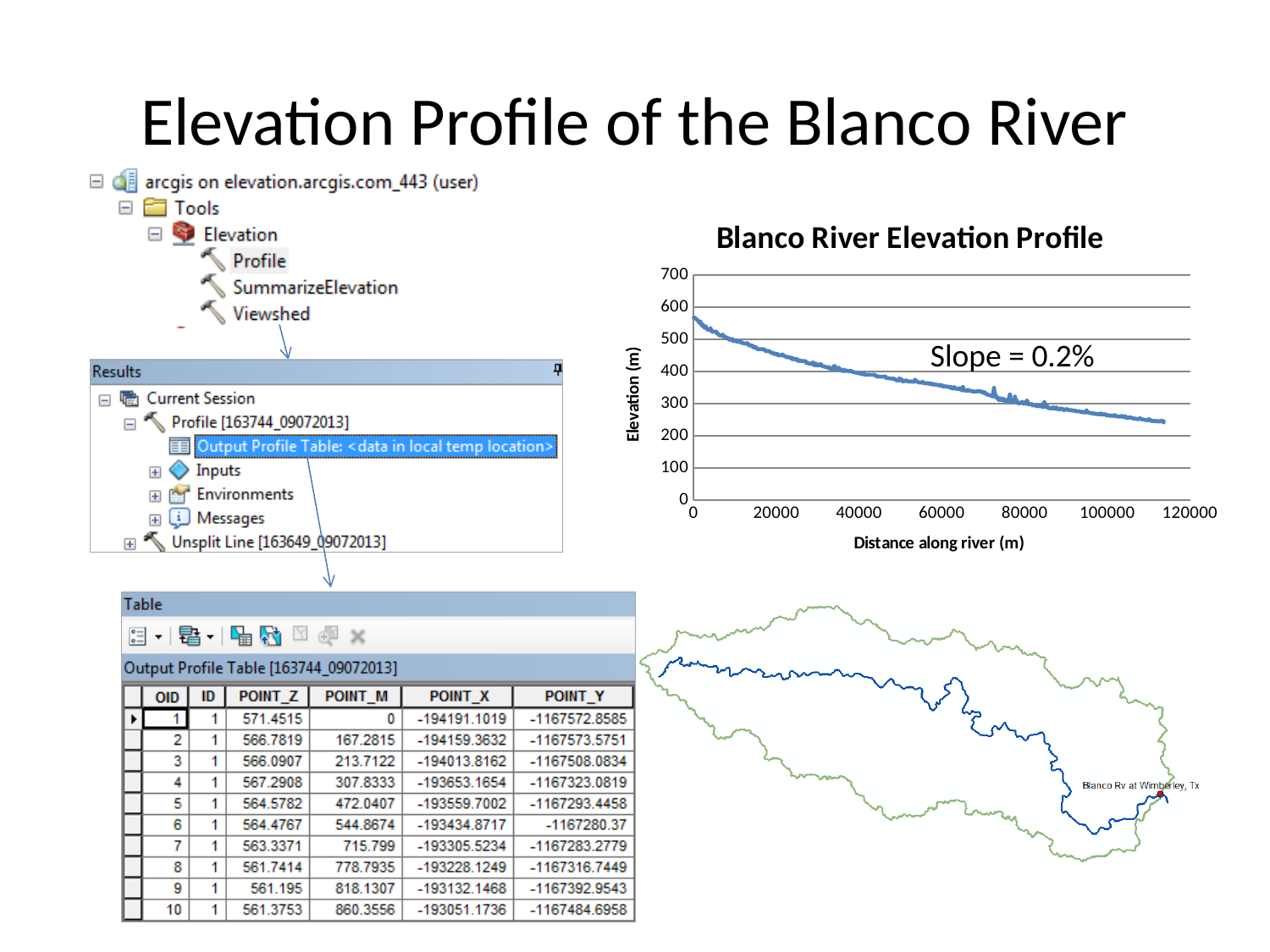
In the Blanco River Elevation Profile chart, is the elevation higher at 20000 m or at 80000 m along the river? 20000 m What slope value is annotated on the Blanco River Elevation Profile chart? Slope = 0.2% In the Blanco River Elevation Profile chart, is the elevation at 60000 m along the river greater or less than 300? greater In the Blanco River Elevation Profile chart, is the elevation at 60000 m along the river greater or less than 400? less What is the maximum value shown on the y axis of the Blanco River Elevation Profile chart? 700 Does elevation rise or fall as distance along the river increases in the Blanco River Elevation Profile chart? fall In the Blanco River Elevation Profile chart, is the elevation at distance 0 m greater or less than 500? greater What is the maximum value shown on the x axis of the Blanco River Elevation Profile chart? 120000 What is the label of the y axis of the Blanco River Elevation Profile chart? Elevation (m) What kind of chart is the Blanco River Elevation Profile? line chart What is the title of the chart on the slide? Blanco River Elevation Profile